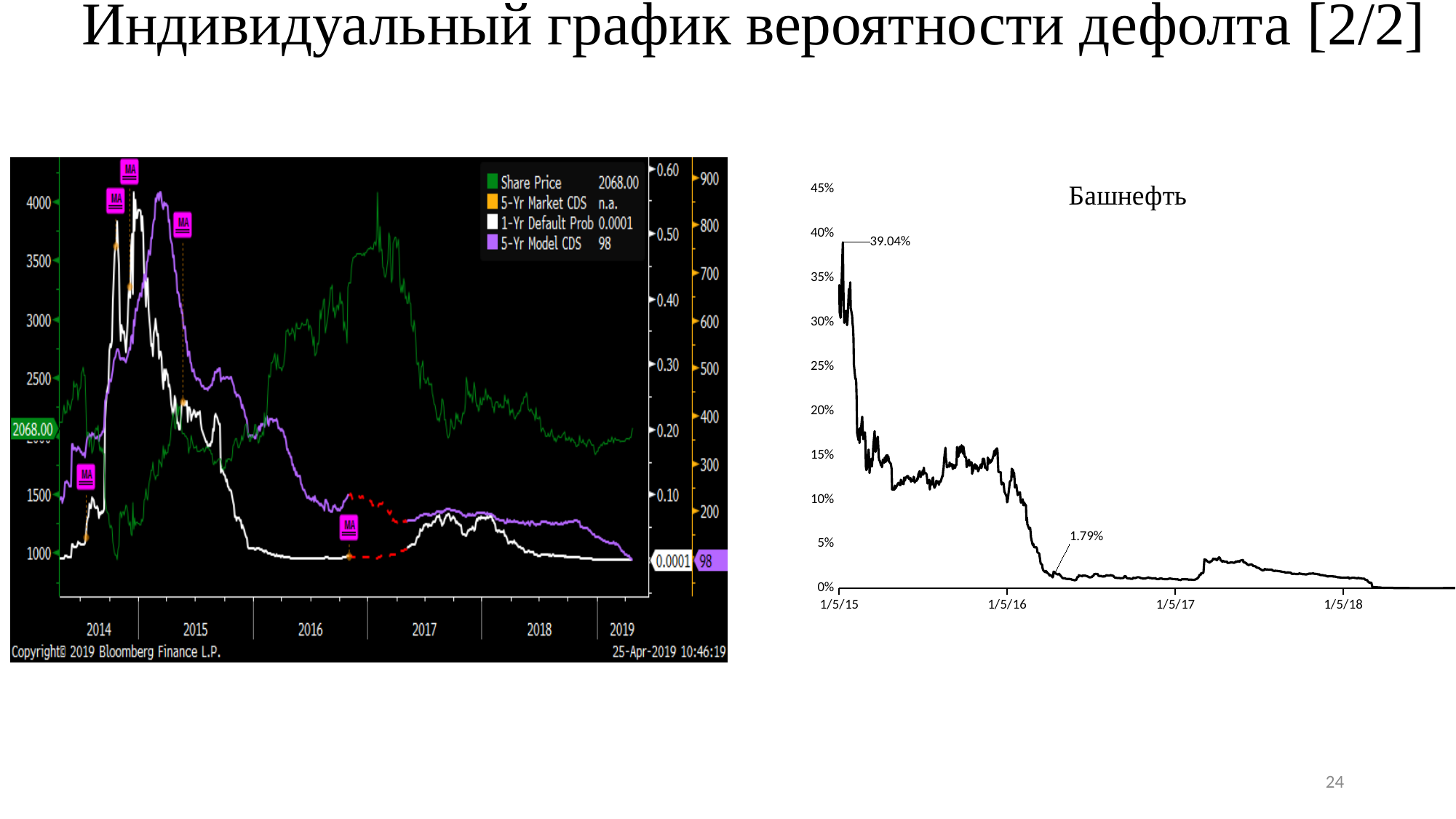
On the right-hand chart (Башнефть), what is the difference between the two labelled values, 39.04% and 1.79%? 37.25% On the right-hand chart (Башнефть), is the value at 1/5/17 greater or less than 5%? less On the left-hand Bloomberg chart, how many series does the legend list? 4 On the left-hand Bloomberg chart, what value is shown in the legend for 1-Yr Default Prob? 0.0001 On the right-hand chart (Башнефть), what is the highest labelled value on the line? 39.04% On the left-hand Bloomberg chart, what value is shown in the legend for Share Price? 2068.00 On the right-hand chart (Башнефть), does the line generally rise or fall from 1/5/15 to 1/5/18? fall On the left-hand Bloomberg chart, what value is shown in the legend for 5-Yr Model CDS? 98 On the right-hand chart (Башнефть), what kind of chart is shown? line chart On the right-hand chart, what is the title of the chart? Башнефть On the right-hand chart (Башнефть), what value is labelled on the line shortly after 1/5/16? 1.79%